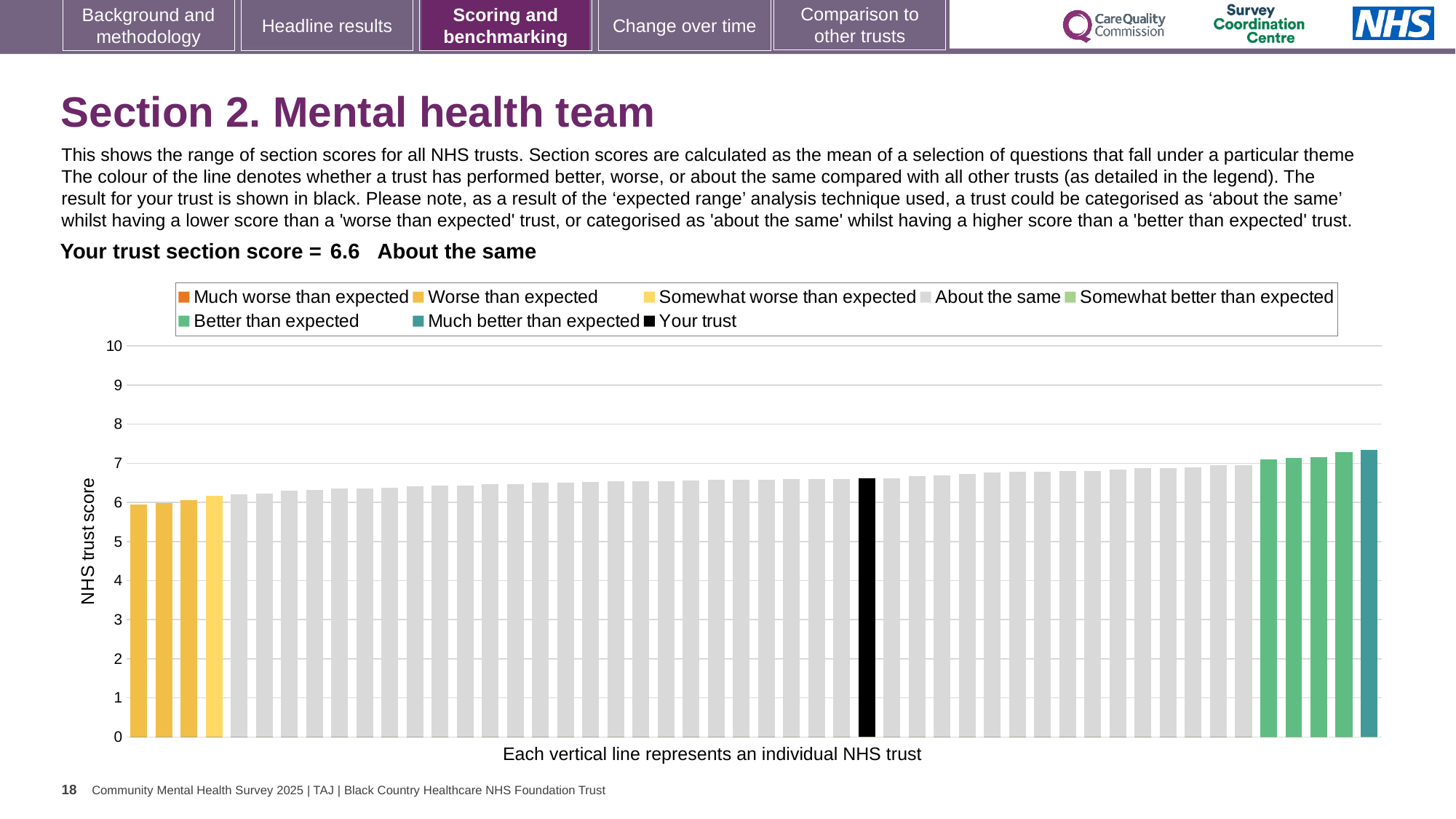
Do the bar values rise or fall from left to right along the x axis? rise How many bars are coloured as 'Much better than expected' (teal)? 1 How many bars are coloured as 'Better than expected' (green)? 4 How many entries does the chart legend list? 8 How many bars are coloured as 'Worse than expected' (dark yellow)? 3 Which legend category does the tallest bar belong to? Much better than expected What is the section score for your trust shown on the slide? 6.6 Is the value of the shortest bar in the chart greater or less than 7? less Is the value of the black 'Your trust' bar greater or less than 7? less What is the label on the vertical axis of the chart? NHS trust score What kind of chart is shown on the slide? bar chart Is the value of the tallest bar in the chart greater or less than 7? greater